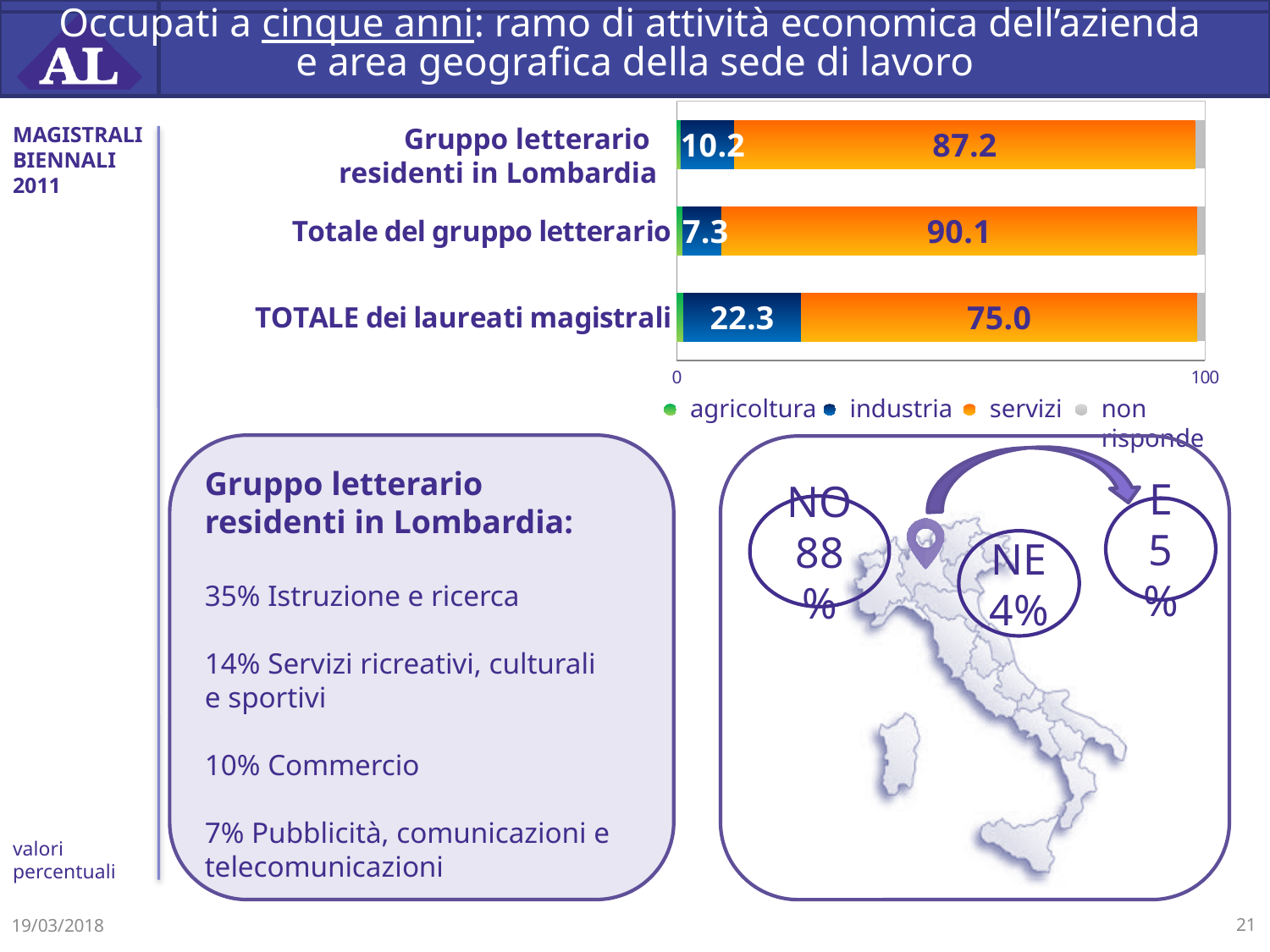
Which series is shown in orange in the chart? servizi What is the value for servizi for 'Gruppo letterario residenti in Lombardia'? 87.2 Which is larger: the industria value for 'Gruppo letterario residenti in Lombardia' or for 'TOTALE dei laureati magistrali'? TOTALE dei laureati magistrali Which category has the lowest value for industria? Totale del gruppo letterario What kind of chart is shown on the slide? Stacked bar chart What is the value for industria for 'TOTALE dei laureati magistrali'? 22.3 How many categories are shown in the bar chart? 3 What is the difference between the servizi values for 'Totale del gruppo letterario' and 'TOTALE dei laureati magistrali'? 15.1 What is the value for industria for 'Totale del gruppo letterario'? 7.3 Which category has the highest value for servizi? Totale del gruppo letterario How many series does the legend list? 4 What is the value for servizi for 'TOTALE dei laureati magistrali'? 75.0